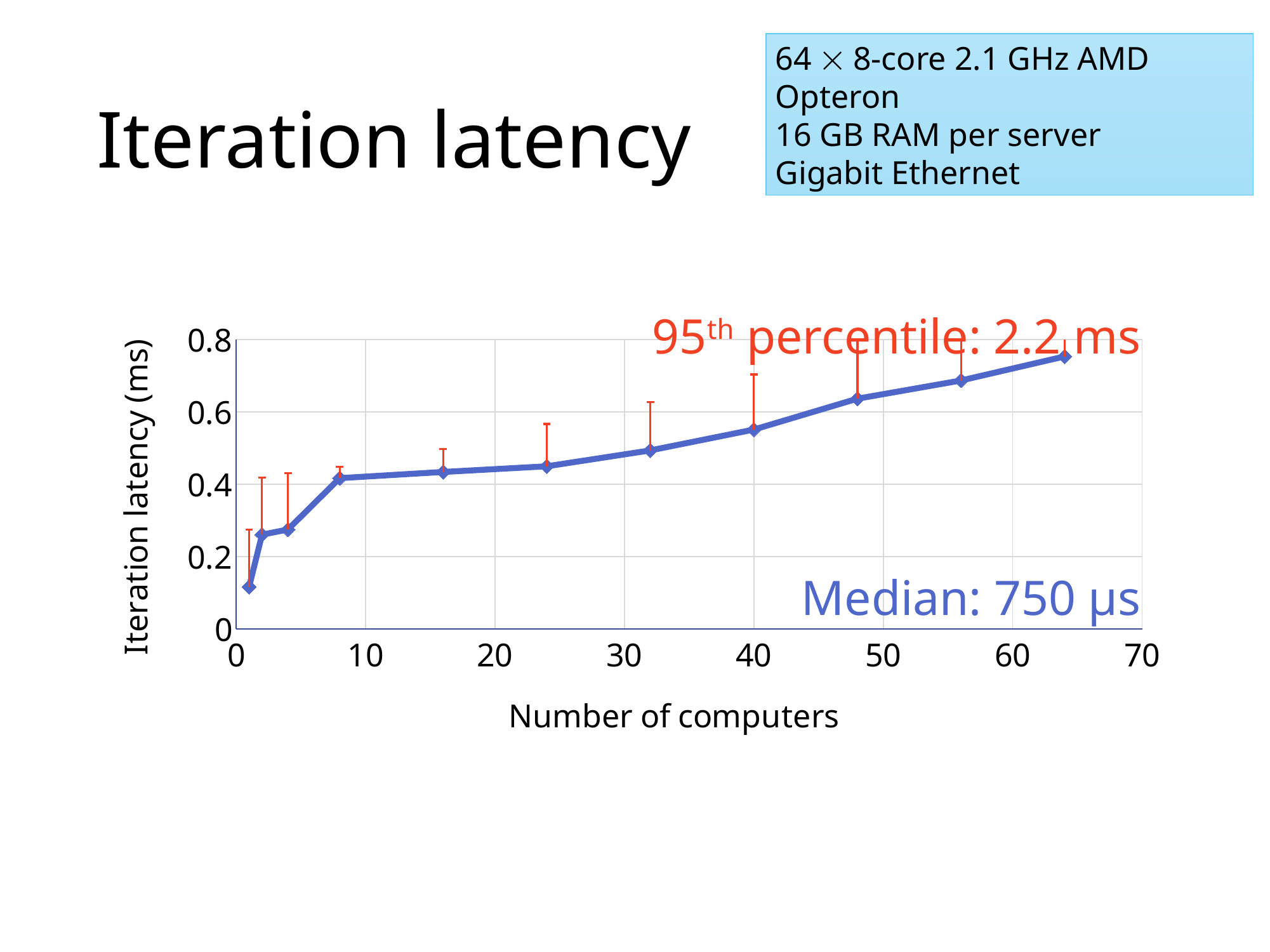
Which has the higher iteration latency: 32 computers or 8 computers? 32 computers What median iteration latency is annotated on the chart? 750 µs Is the iteration latency for 1 computer greater or less than 0.2 ms? less How many data points are plotted on the line? 11 Is the iteration latency for 40 computers greater or less than 0.4 ms? greater Does iteration latency rise or fall as the number of computers increases? rise At which number of computers is the iteration latency lowest? 1 What is the label of the x axis? Number of computers Is the iteration latency for 8 computers greater or less than 0.6 ms? less What kind of chart is shown on the slide? line chart At which number of computers is the iteration latency highest? 64